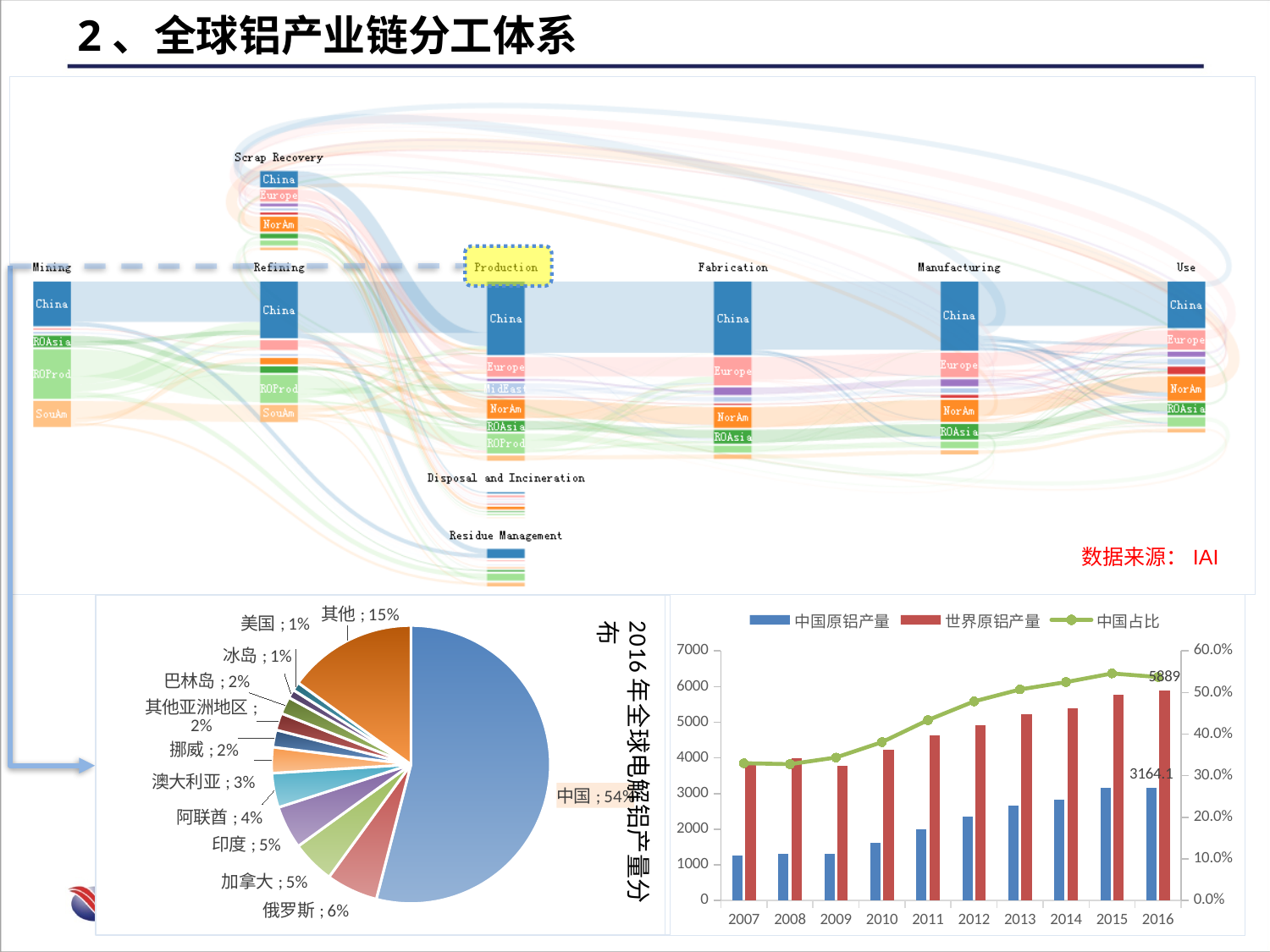
In the pie chart titled 2016年全球电解铝产量分布, which named country has the largest share? 中国 In the bottom-right chart, what is the value of 世界原铝产量 in 2016? 5889 In the bottom-right chart, how many series does the legend list? 3 In the bottom-right chart, how many years are shown on the x axis? 10 In the pie chart titled 2016年全球电解铝产量分布, how many slices are there? 12 In the pie chart titled 2016年全球电解铝产量分布, what is the difference in percentage points between 加拿大 and 澳大利亚? 2 What kind of chart is the bottom-left chart titled 2016年全球电解铝产量分布? pie chart In the pie chart titled 2016年全球电解铝产量分布, which is larger, the share of 印度 or the share of 阿联酋? 印度 In the pie chart titled 2016年全球电解铝产量分布, what share does 俄罗斯 have? 6% In the pie chart titled 2016年全球电解铝产量分布, what share does 中国 have? 54% In the bottom-right chart, is the value of 中国原铝产量 in 2007 greater or less than 2000? less In the bottom-right chart, what is the value of 中国原铝产量 in 2016? 3164.1